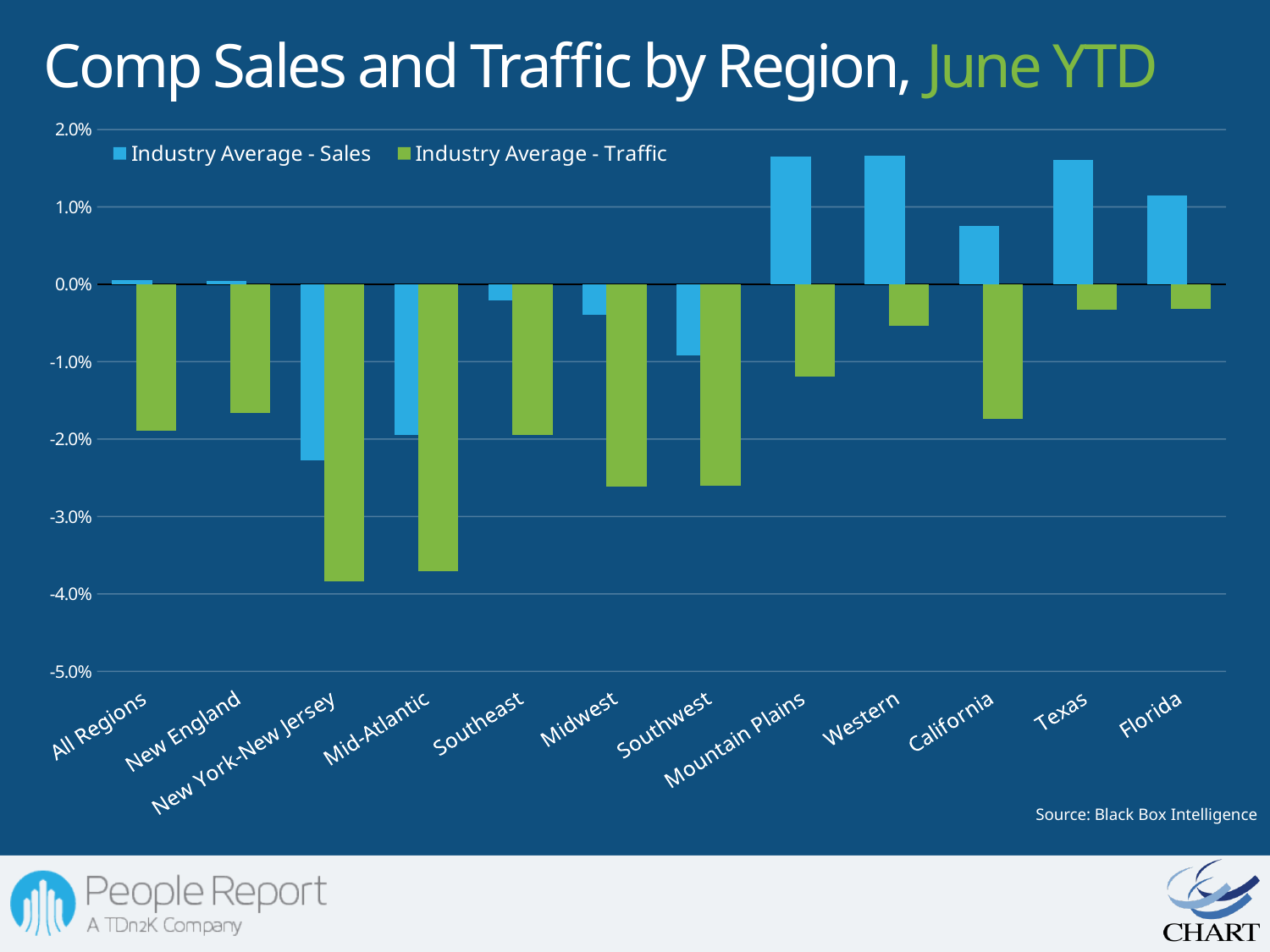
How many series does the chart's legend list? 2 Which region has the lowest Industry Average - Sales value? New York-New Jersey What kind of chart is shown on the slide? Bar chart Which is larger, the Industry Average - Traffic value for Mountain Plains or for California? Mountain Plains Is the Industry Average - Traffic value for Western greater or less than -1.0%? greater Which is larger, the Industry Average - Sales value for Midwest or for Southwest? Midwest What colour are the Industry Average - Traffic bars in the chart? Green Is the Industry Average - Traffic value for Mid-Atlantic greater or less than -3.0%? less Is the Industry Average - Sales value for New York-New Jersey greater or less than -2.0%? less How many regions are shown on the x axis of the chart? 12 Which region has the lowest Industry Average - Traffic value? New York-New Jersey